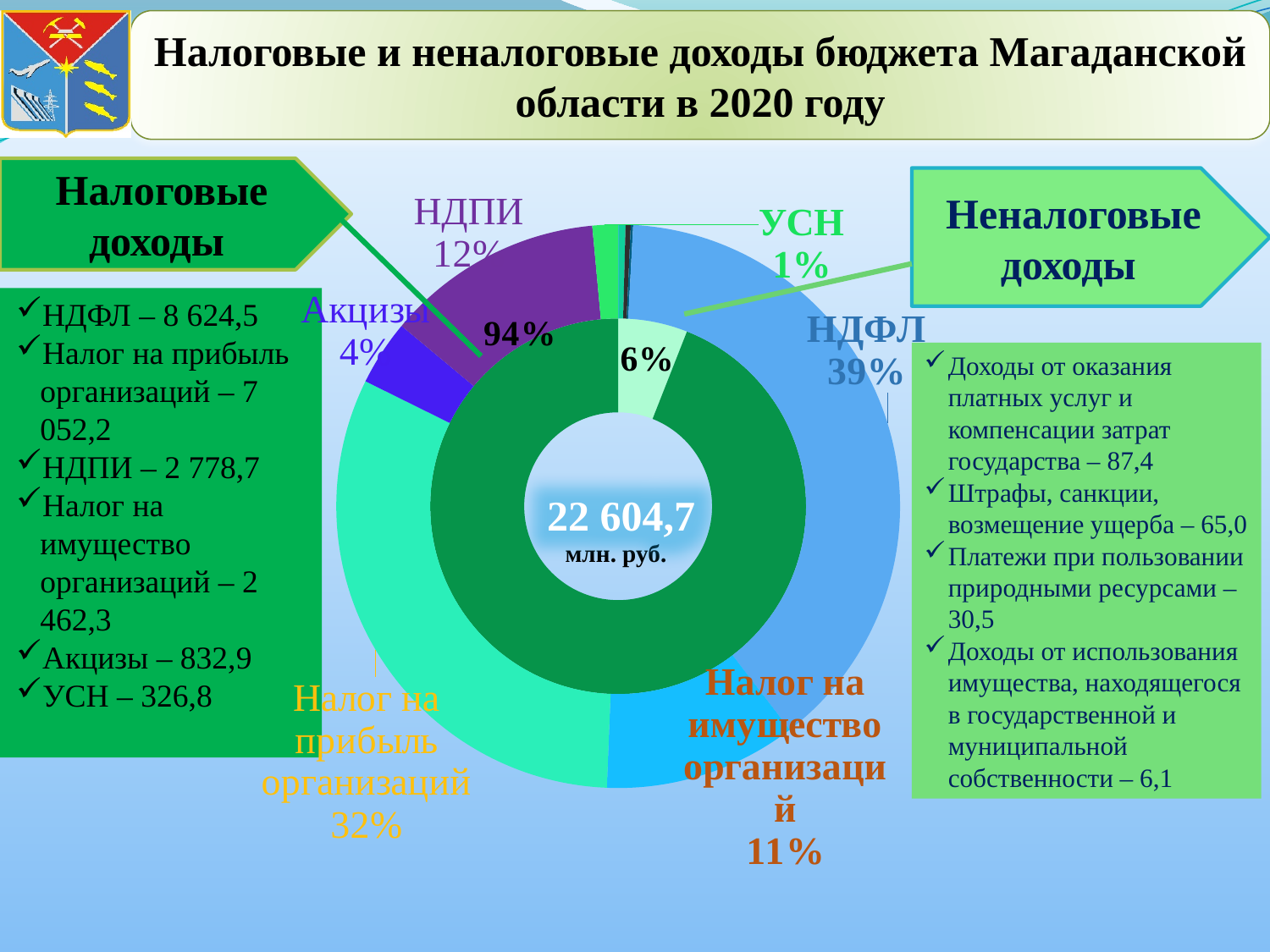
What share of the outer ring does НДПИ hold? 12% What share of the outer ring does Налог на прибыль организаций hold? 32% What share of the outer ring does УСН hold? 1% Which has the larger share in the outer ring, НДПИ or Акцизы? НДПИ Which category in the outer ring has the largest share? НДФЛ What total value is printed in the centre of the chart? 22 604,7 млн. руб. What kind of chart is shown on the slide? doughnut chart What is the difference in percentage points between the НДФЛ share and the Налог на прибыль организаций share? 7